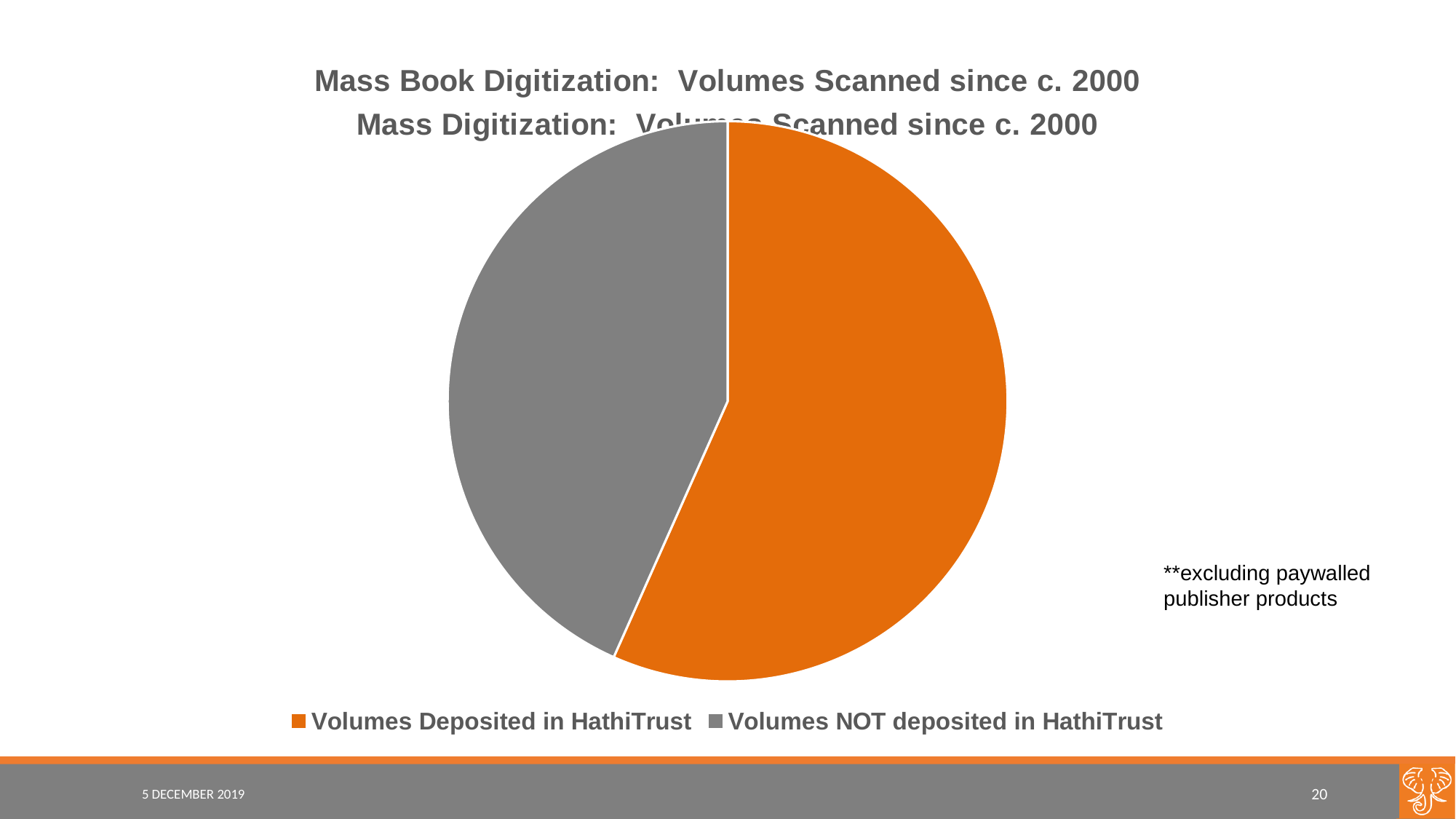
Which slice of the pie chart is the largest? Volumes Deposited in HathiTrust How many entries does the legend list? 2 What colour is the slice for Volumes NOT deposited in HathiTrust? gray Which is larger: the slice for Volumes Deposited in HathiTrust or the slice for Volumes NOT deposited in HathiTrust? Volumes Deposited in HathiTrust What colour is the slice for Volumes Deposited in HathiTrust? orange What kind of chart is shown on the slide? pie chart Which slice of the pie chart is the smallest? Volumes NOT deposited in HathiTrust How many slices does the pie chart have? 2